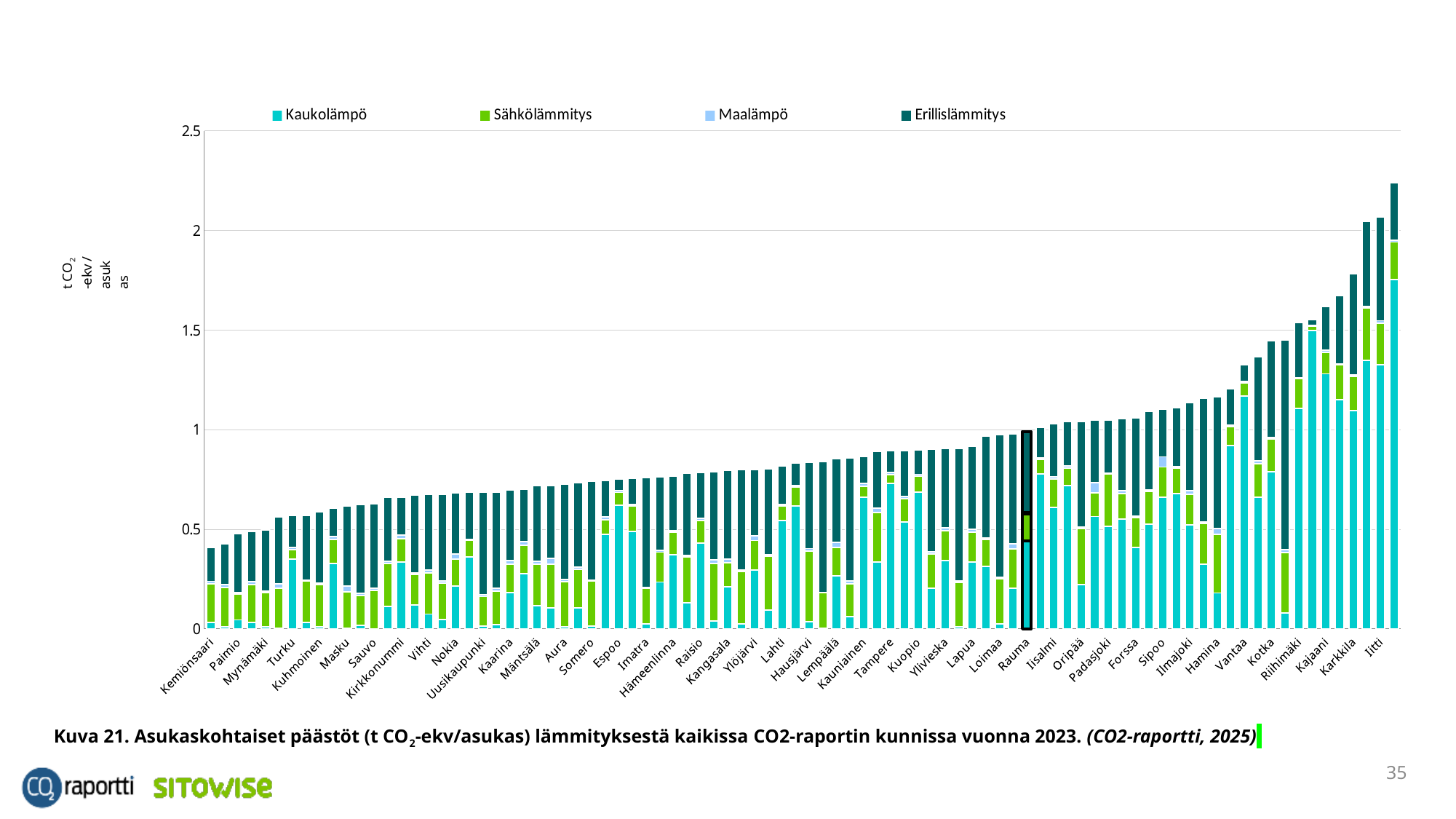
Is the total value for Vantaa greater or less than 1? greater What kind of chart is shown on the slide? Stacked bar chart Do the total bar heights rise or fall from left to right along the x axis? Rise Which has the larger total value, Kotka or Espoo? Kotka Is the total value for Kemiönsaari greater or less than 0.5? less Is the total value for Iitti greater or less than 2? greater How many series does the legend list? 4 Which municipality's bar is highlighted with a black outline? Rauma Which legend entry is shown in dark teal? Erillislämmitys Which municipality has the lowest total emissions per inhabitant in the chart? Kemiönsaari